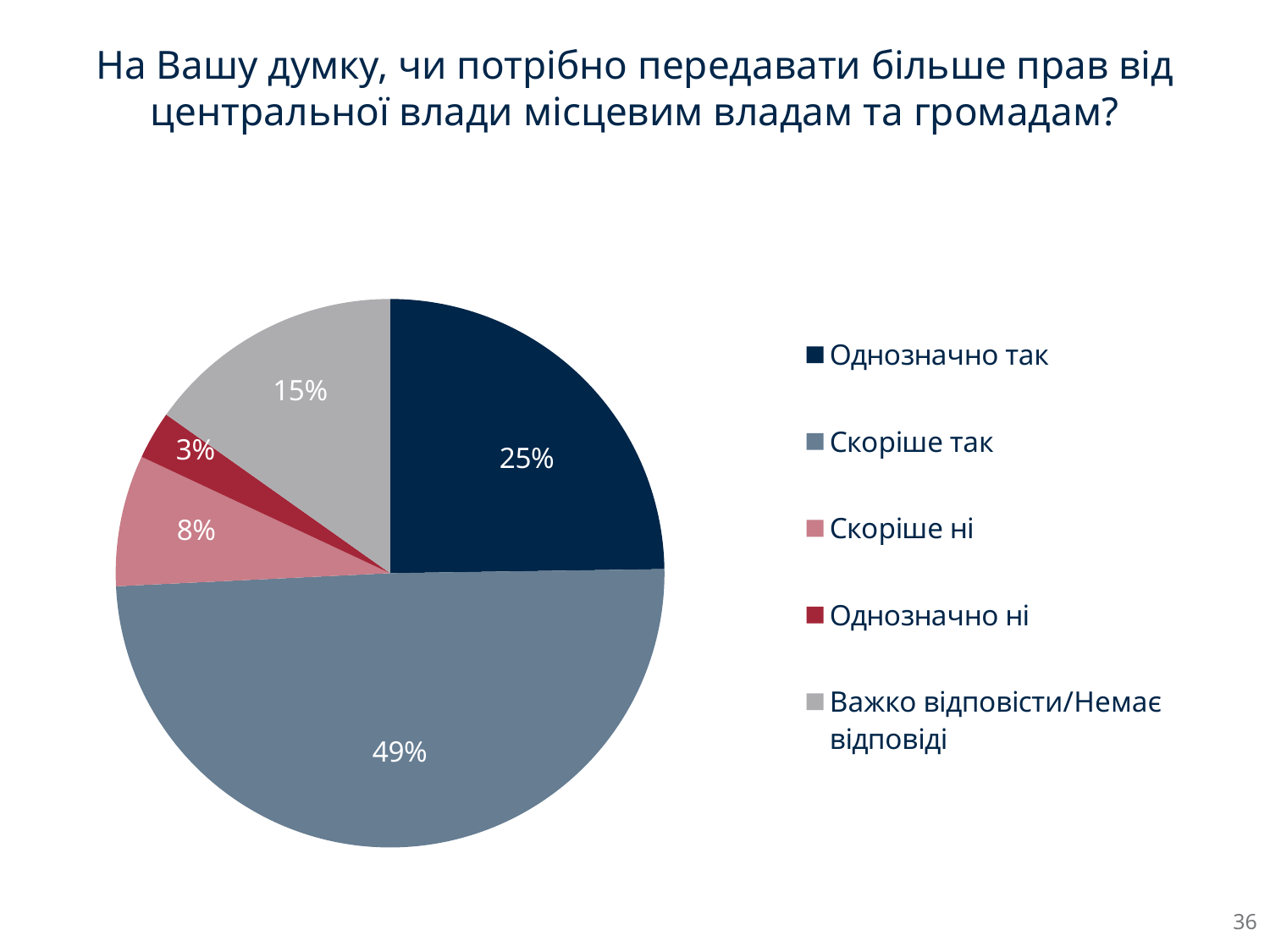
What kind of chart is shown on the slide? Pie chart What share of the pie does "Однозначно так" represent? 25% What is the value for "Скоріше ні"? 8% Which category has the smallest slice of the pie? Однозначно ні What is the difference between the values for "Скоріше так" and "Однозначно так"? 24% What is the value for "Однозначно ні"? 3% Which category has the largest slice of the pie? Скоріше так What share of the pie does "Скоріше так" represent? 49% Which is larger, the value for "Важко відповісти/Немає відповіді" or the value for "Скоріше ні"? Важко відповісти/Немає відповіді What is the value for "Важко відповісти/Немає відповіді"? 15% How many categories does the pie chart show? 5 What colour is the slice for "Однозначно ні"? Dark red